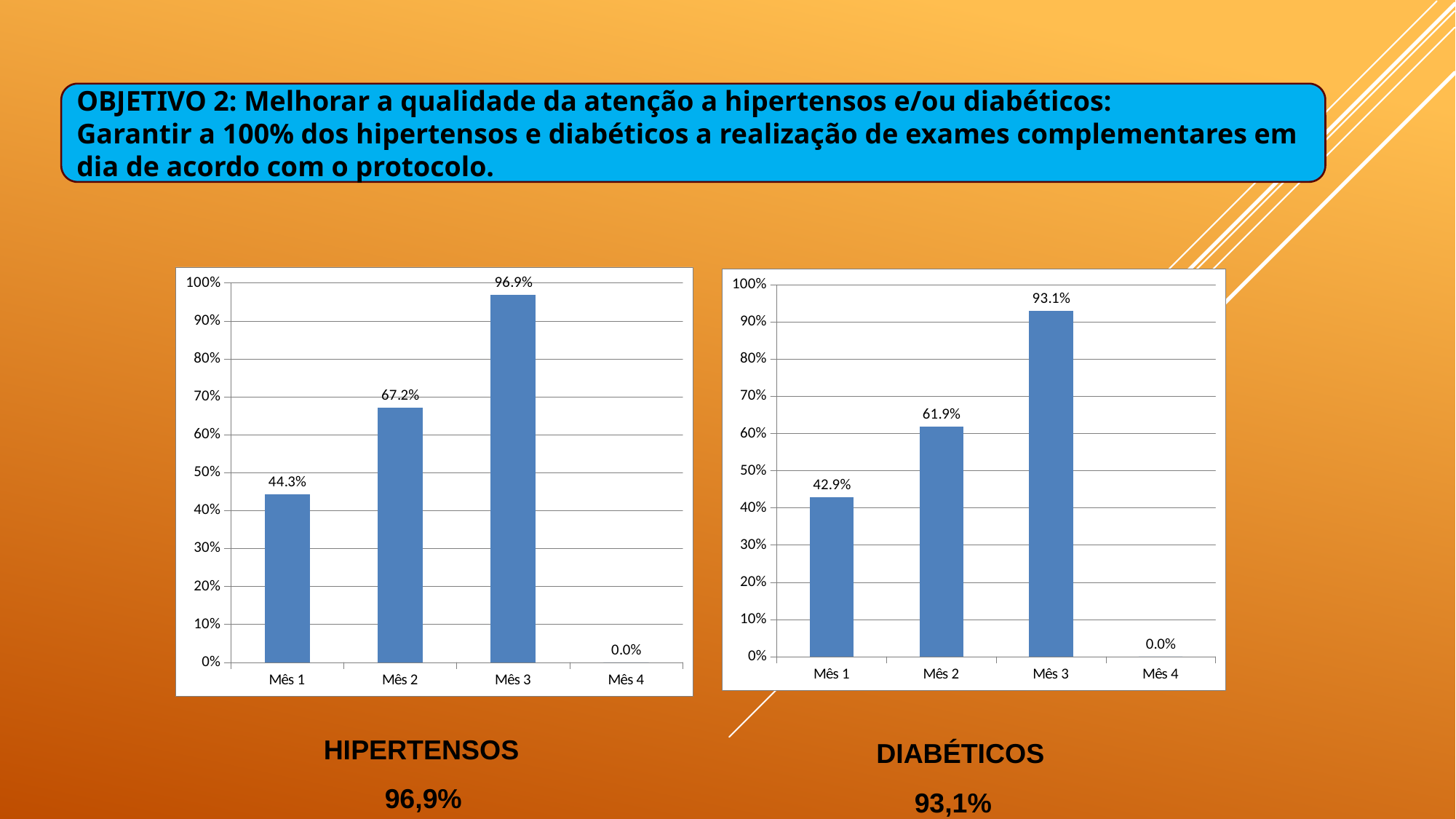
How many months are shown on the x axis of the HIPERTENSOS chart (left)? 4 What kind of chart is the DIABÉTICOS chart (right)? Bar chart What is the value for Mês 4 in the DIABÉTICOS chart (right)? 0.0% In the DIABÉTICOS chart (right), what is the value for Mês 1? 42.9% Which is larger: the Mês 3 value in the HIPERTENSOS chart or the Mês 3 value in the DIABÉTICOS chart? HIPERTENSOS (96.9%) In the DIABÉTICOS chart (right), what is the difference between the values for Mês 3 and Mês 2? 31.2% In the HIPERTENSOS chart (left), what is the value for Mês 2? 67.2% In the HIPERTENSOS chart (left), which month has the highest value? Mês 3 In the HIPERTENSOS chart (left), what is the difference between the values for Mês 3 and Mês 1? 52.6% In the HIPERTENSOS chart (left), do the values rise or fall from Mês 1 to Mês 3? Rise In the DIABÉTICOS chart (right), is the value for Mês 2 greater or less than 60%? greater In the DIABÉTICOS chart (right), which month has the lowest value? Mês 4